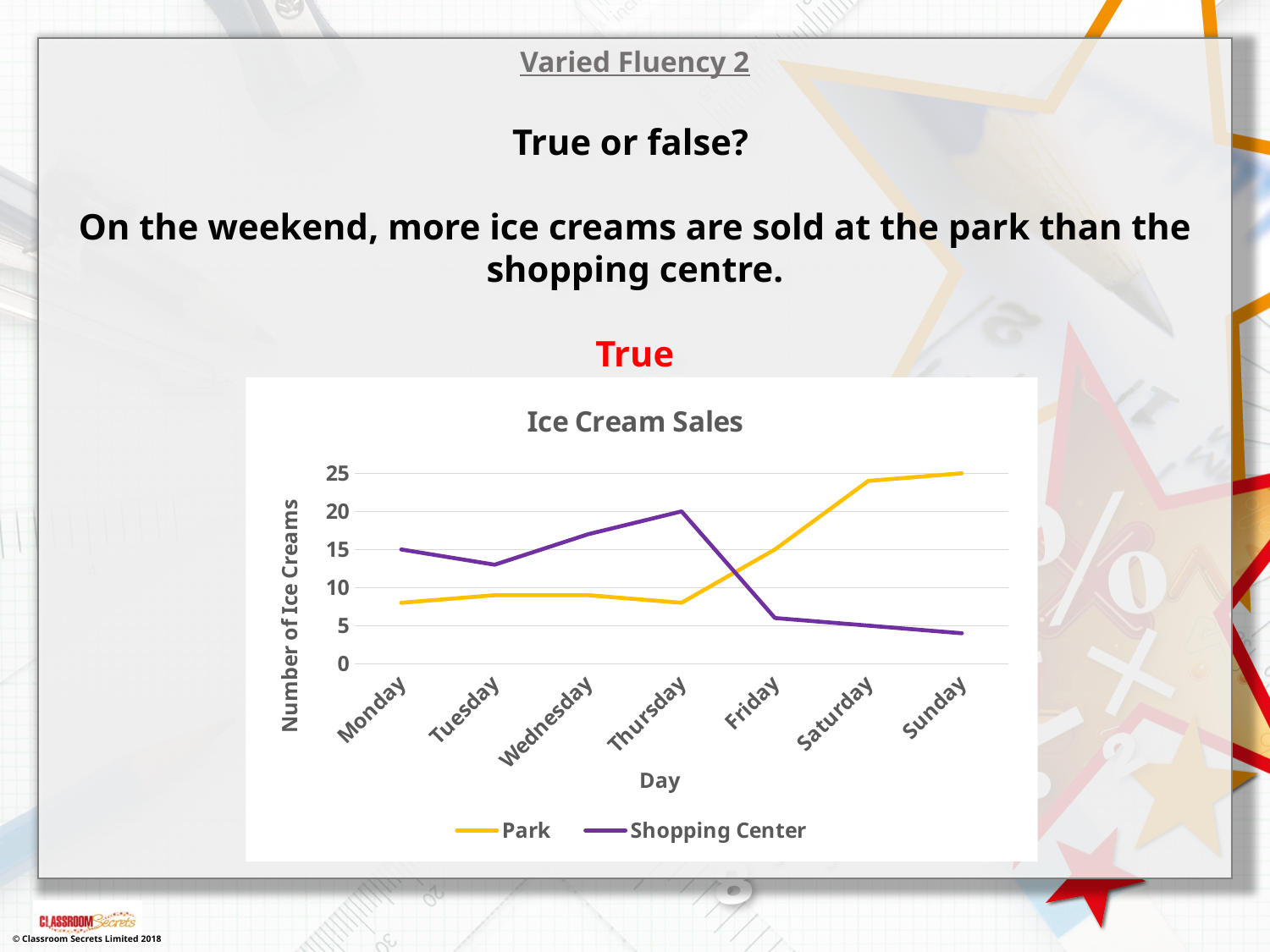
What type of chart is shown on the slide? Line chart How many ice creams were sold at the Park on Sunday? 25 How many days are shown on the x axis? 7 On which day is the Shopping Center value lowest? Sunday Is the value for the Park on Saturday greater or less than 20? greater On which day is the Park value highest? Sunday Do the Shopping Center values rise or fall from Thursday to Sunday? Fall How many series does the legend list? 2 How many ice creams were sold at the Shopping Center on Monday? 15 What is the title of the chart? Ice Cream Sales On Thursday, which is larger: Park or Shopping Center? Shopping Center How many ice creams were sold at the Shopping Center on Thursday? 20